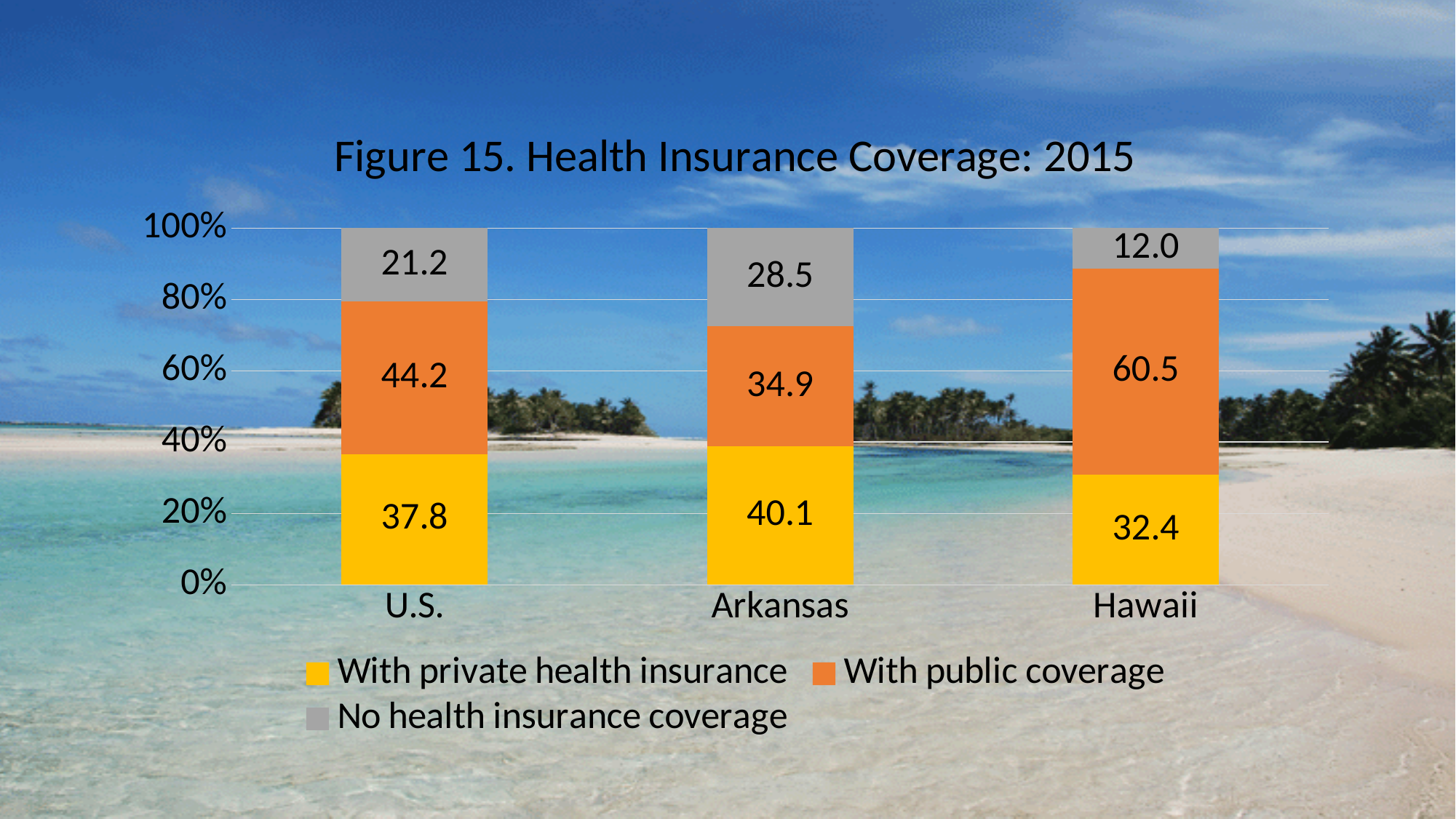
What kind of chart is shown on the slide? Stacked bar chart How many series does the legend list? 3 Which category has the lowest value for 'No health insurance coverage'? Hawaii Which category has the highest value for 'With private health insurance'? Arkansas What is the difference between the 'With public coverage' values for Hawaii and Arkansas? 25.6 Which category has the highest value for 'With public coverage'? Hawaii What is the difference between the 'No health insurance coverage' values for Arkansas and the U.S.? 7.3 What is the value for 'With public coverage' for Hawaii? 60.5 Which is larger, the 'With private health insurance' value for Arkansas or for Hawaii? Arkansas How many categories are shown on the x axis? 3 What is the value for 'No health insurance coverage' for Arkansas? 28.5 What is the value for 'With private health insurance' for the U.S.? 37.8